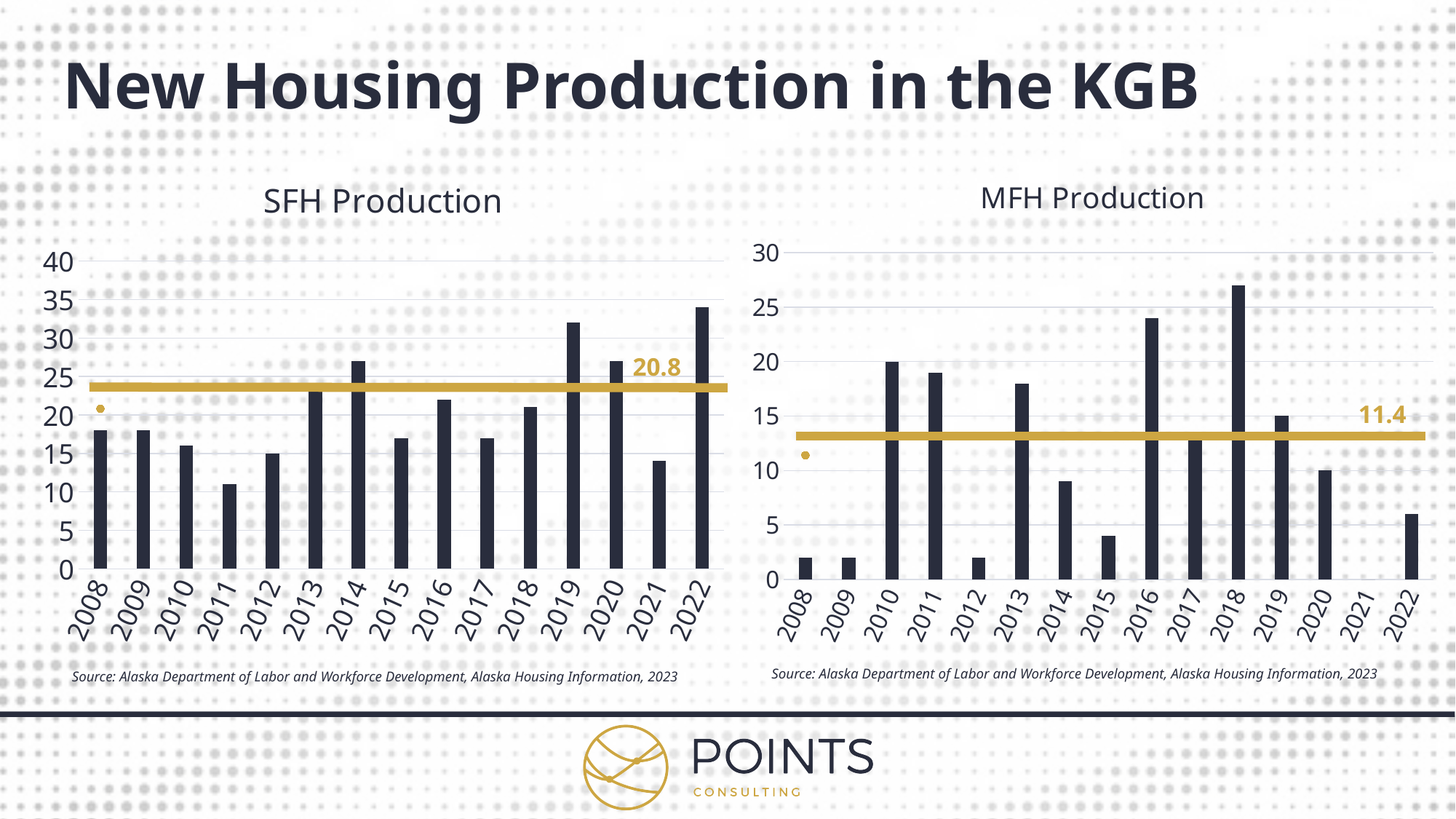
In the SFH Production chart, is the value for 2011 greater or less than 15? less In the MFH Production chart, is the value for 2015 greater or less than 5? less In the MFH Production chart, which year has the highest bar? 2018 In the MFH Production chart, what value is labelled on the horizontal gold line? 11.4 How many years are shown on the x axis of the MFH Production chart? 15 In the SFH Production chart, which year has the larger value, 2014 or 2021? 2014 In the SFH Production chart, is the value for 2019 greater or less than 30? greater In the SFH Production chart, which year has the lowest bar? 2011 In the SFH Production chart, which year has the highest bar? 2022 What kind of chart is the SFH Production chart? Bar chart In the SFH Production chart, what value is labelled on the horizontal gold line? 20.8